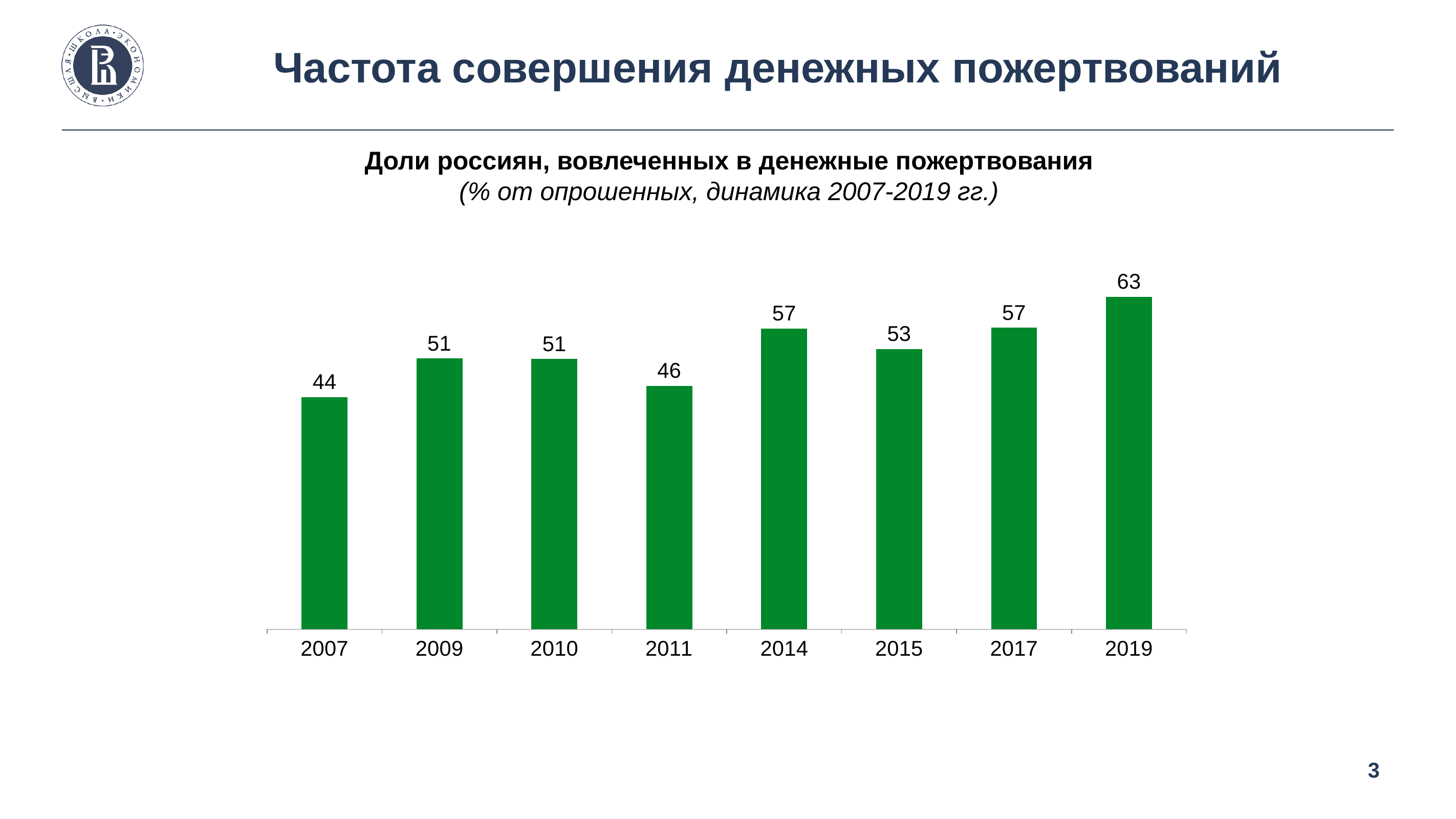
What is the value for 2007? 44 What is the value for 2011? 46 What kind of chart is shown on the slide? bar chart What is the value for 2019? 63 How many years are shown on the x axis? 8 What is the difference between the values for 2014 and 2011? 11 What is the difference between the values for 2019 and 2007? 19 Which year has the lowest value? 2007 What colour are the bars in the chart? green What is the value for 2015? 53 Which is larger, the value for 2015 or the value for 2017? 2017 Which year has the highest value? 2019